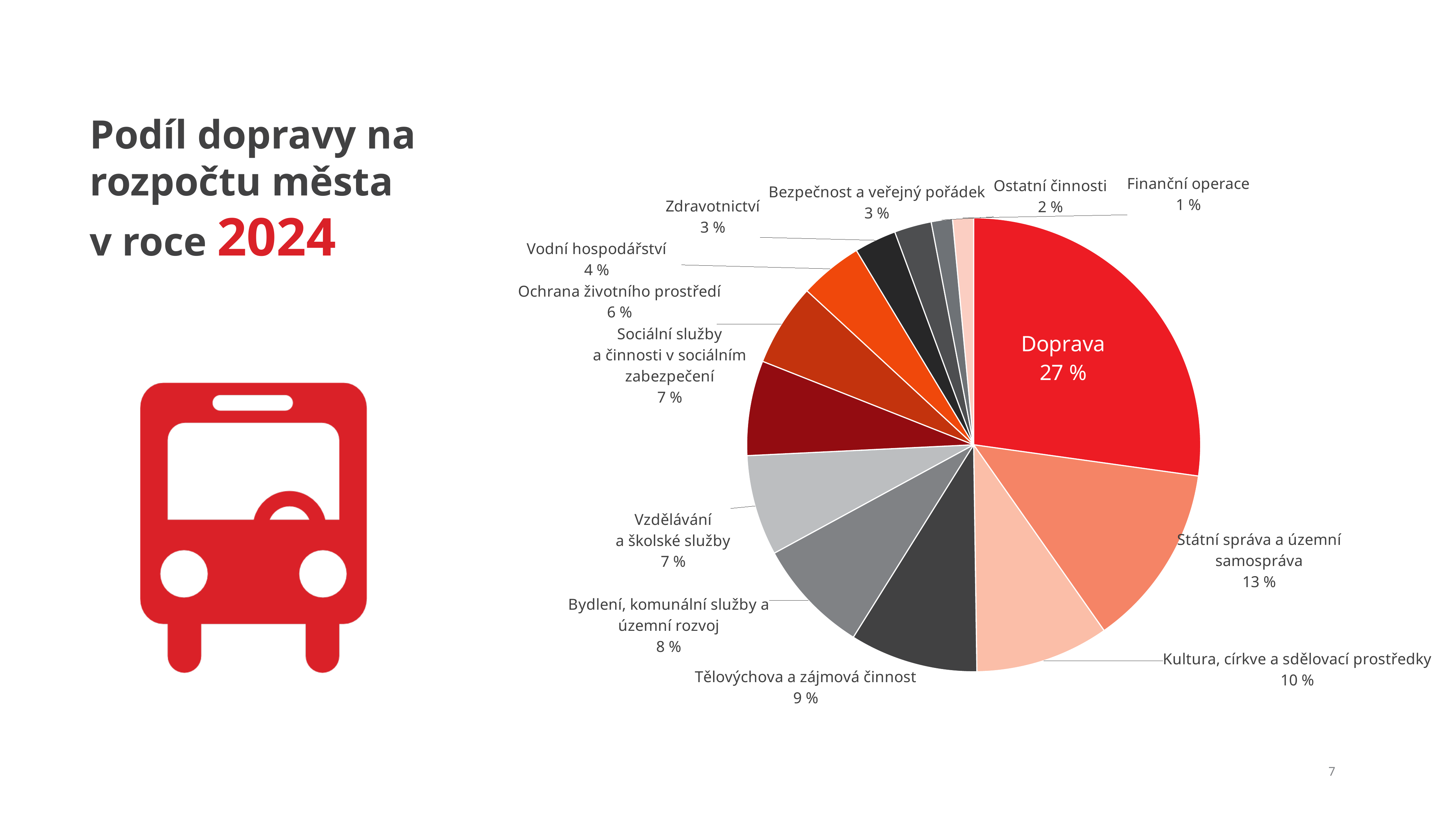
Which category has the largest slice of the pie chart? Doprava What percentage is shown for Státní správa a územní samospráva? 13 % How many categories are shown in the pie chart? 13 Which is larger: the share for Bydlení, komunální služby a územní rozvoj or the share for Vodní hospodářství? Bydlení, komunální služby a územní rozvoj What percentage is shown for Ochrana životního prostředí? 6 % What percentage is shown for Tělovýchova a zájmová činnost? 9 % What type of chart is shown on the slide? Pie chart What is the difference in percentage points between Doprava and Státní správa a územní samospráva? 14 What percentage is shown for Kultura, církve a sdělovací prostředky? 10 % What is the combined share of Zdravotnictví and Bezpečnost a veřejný pořádek? 6 % Which category has the smallest slice of the pie chart? Finanční operace What share of the city budget does Doprava (transport) take in the pie chart? 27 %